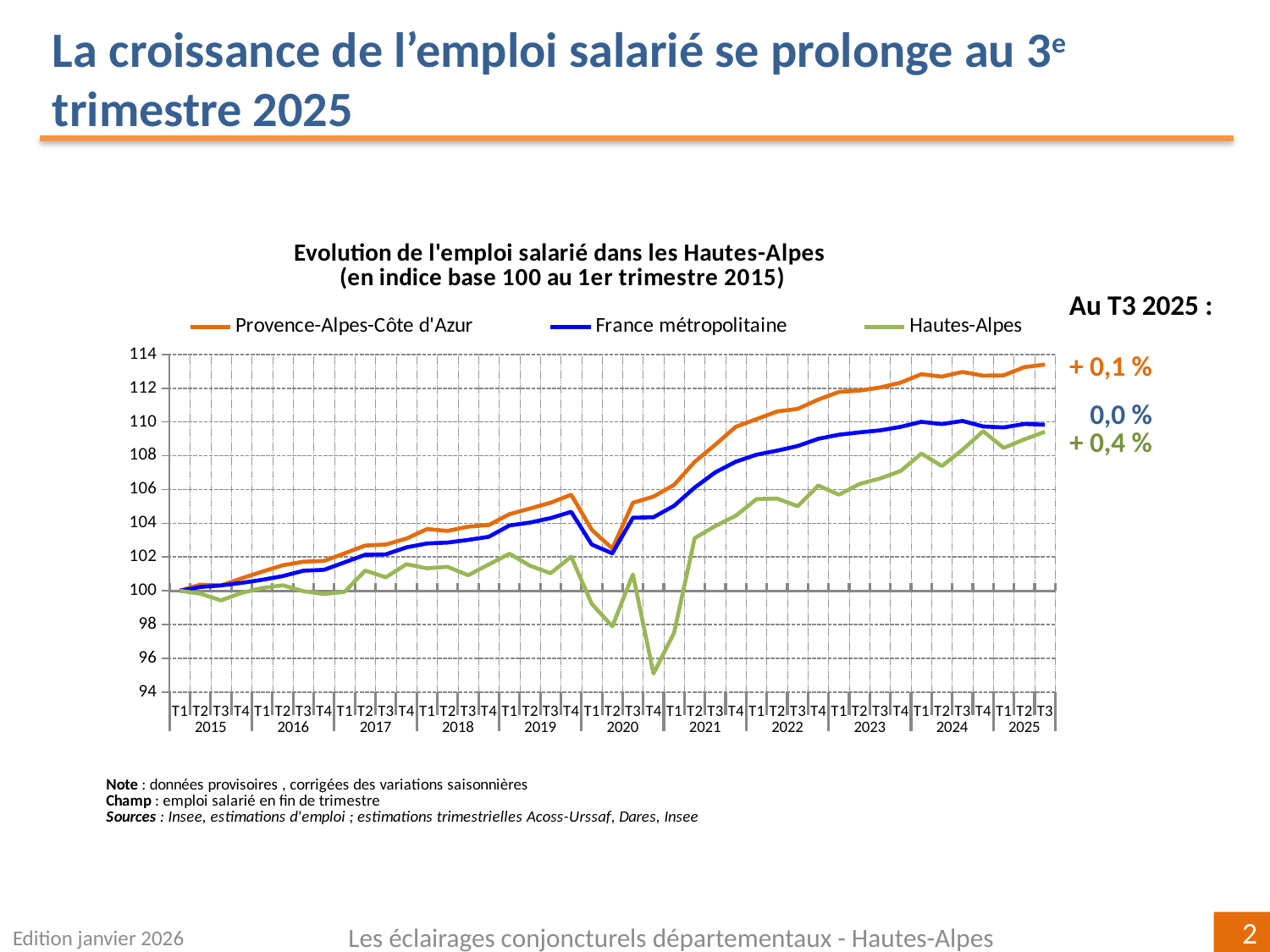
At T3 2025, is the value for Provence-Alpes-Côte d'Azur greater or less than 112? greater Which series has the lowest value at T4 2020? Hautes-Alpes Which series has the highest value at T3 2025? Provence-Alpes-Côte d'Azur At T2 2020, is the value for Hautes-Alpes greater or less than 100? less Which three series are listed in the chart legend? Provence-Alpes-Côte d'Azur, France métropolitaine, Hautes-Alpes What is the base of the index used in the chart, according to its title? base 100 au 1er trimestre 2015 Does the Provence-Alpes-Côte d'Azur series rise or fall overall between T1 2015 and T3 2025? rise How many series does the legend list? 3 What kind of chart is shown on the slide? line chart At T4 2020, is the value for Hautes-Alpes greater or less than 96? less According to the annotation at T3 2025, what is the quarterly change shown for Hautes-Alpes? + 0,4 % At T3 2025, which is larger: the value for Provence-Alpes-Côte d'Azur or the value for Hautes-Alpes? Provence-Alpes-Côte d'Azur